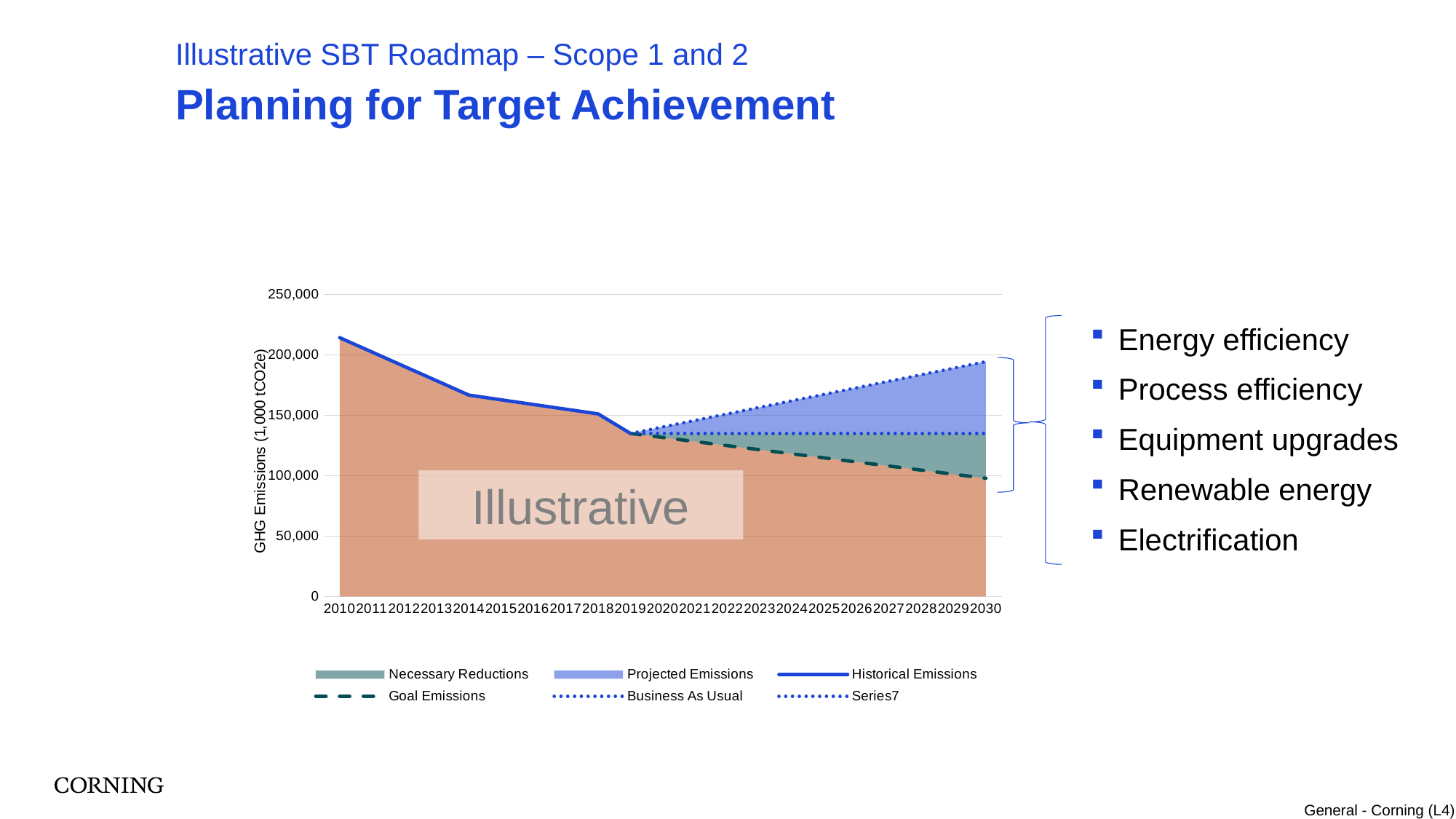
Is the Goal Emissions value for 2030 greater or less than 150,000? less What kind of chart is shown on the slide? combination area and line chart Is the Business As Usual value for 2030 greater or less than 150,000? greater Does the Business As Usual line rise or fall from 2019 to 2030? rise Do Historical Emissions rise or fall from 2010 to 2019? fall Is the Historical Emissions value for 2010 greater or less than 200,000? greater How many series does the chart legend list? 6 What is the label on the chart's y axis? GHG Emissions (1,000 tCO2e) How many years are shown along the x axis of the chart? 21 In 2030, which is larger: Business As Usual or Goal Emissions? Business As Usual